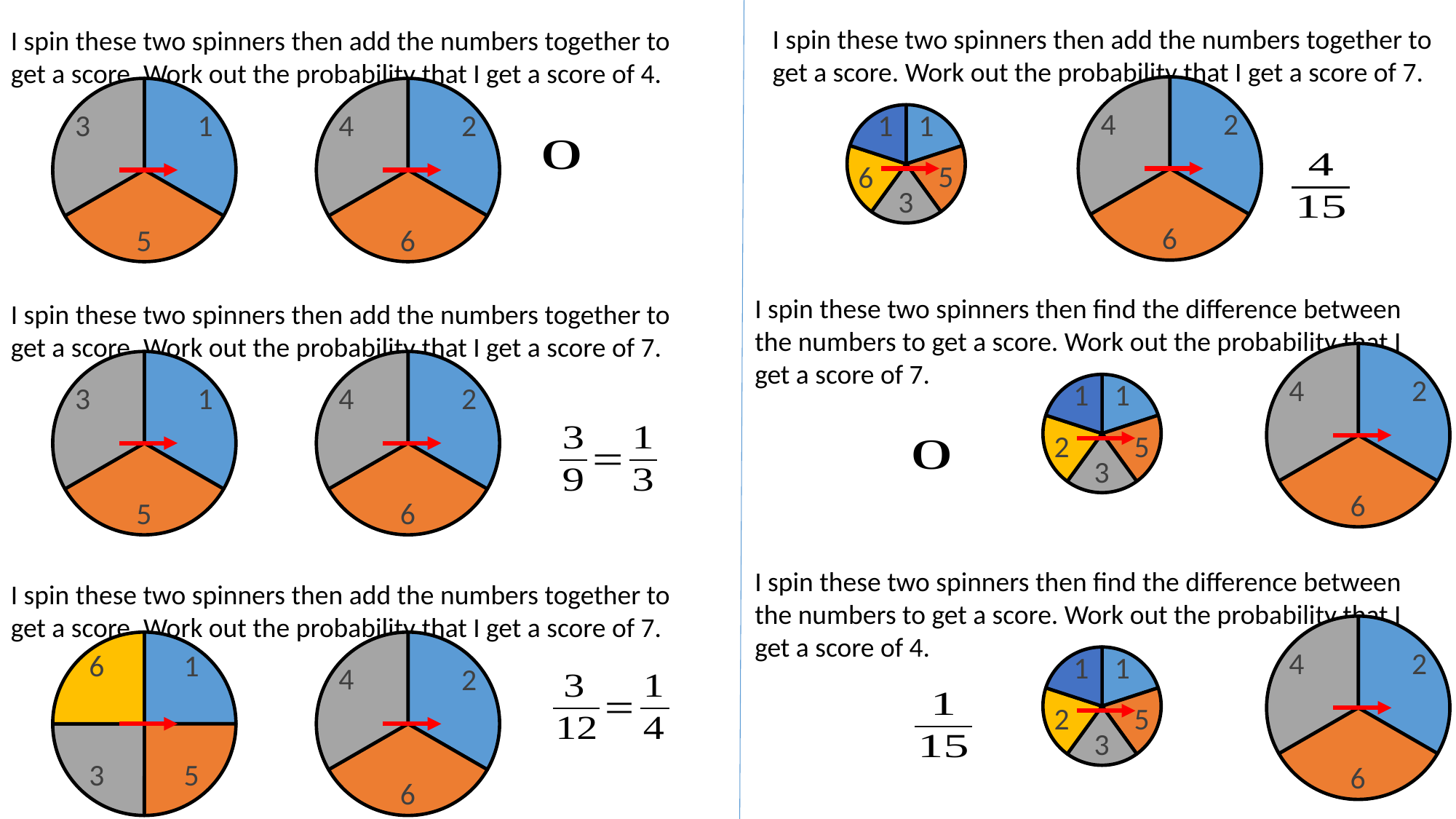
In the bottom-left question (score of 7), how many sectors does the left spinner have? 4 In the bottom-left question (score of 7), what number is on the yellow sector of the left spinner? 6 In the top-right question (score of 7), how many sectors does the small left spinner have? 5 What kind of chart are the spinners drawn as? pie chart In the middle-left question (score of 7), what colour is the sector labelled 4 on the right spinner? grey In the bottom-right question (difference, score of 4), what number is on the yellow sector of the small spinner? 2 In the top-left question (score of 4), what colour is the sector labelled 5 on the left spinner? orange In the top-left question (score of 4), what numbers are on the right spinner? 2, 4, 6 In the top-right question (score of 7), what numbers are on the small left spinner? 1, 1, 5, 3, 6 In the top-left question (score of 4), how many sectors does the left spinner have? 3 In the middle-right question (difference, score of 7), what number is on the orange sector of the large spinner? 6